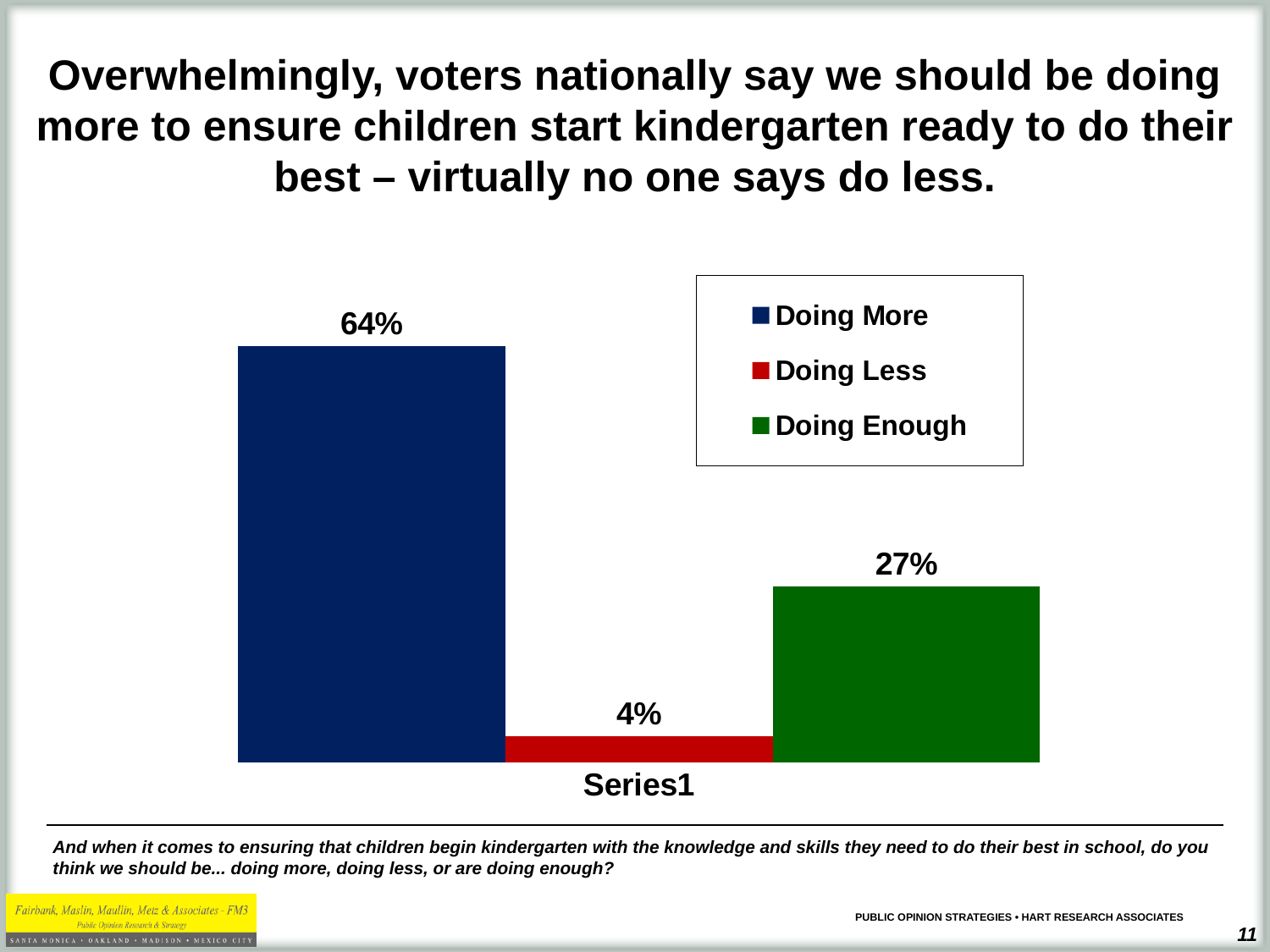
What percentage of voters say we should be doing less? 4% What percentage of voters say we are doing enough? 27% Which is larger, Doing Enough or Doing Less? Doing Enough What kind of chart is shown on the slide? Bar chart How many series does the legend list? 3 Which response has the highest percentage? Doing More What is the difference between the Doing Enough and Doing Less percentages? 23% What percentage of voters say we should be doing more? 64% What is the difference between the Doing More and Doing Enough percentages? 37% Which response has the lowest percentage? Doing Less What is the label shown on the x axis beneath the bars? Series1 What colour is the Doing Less bar? Red